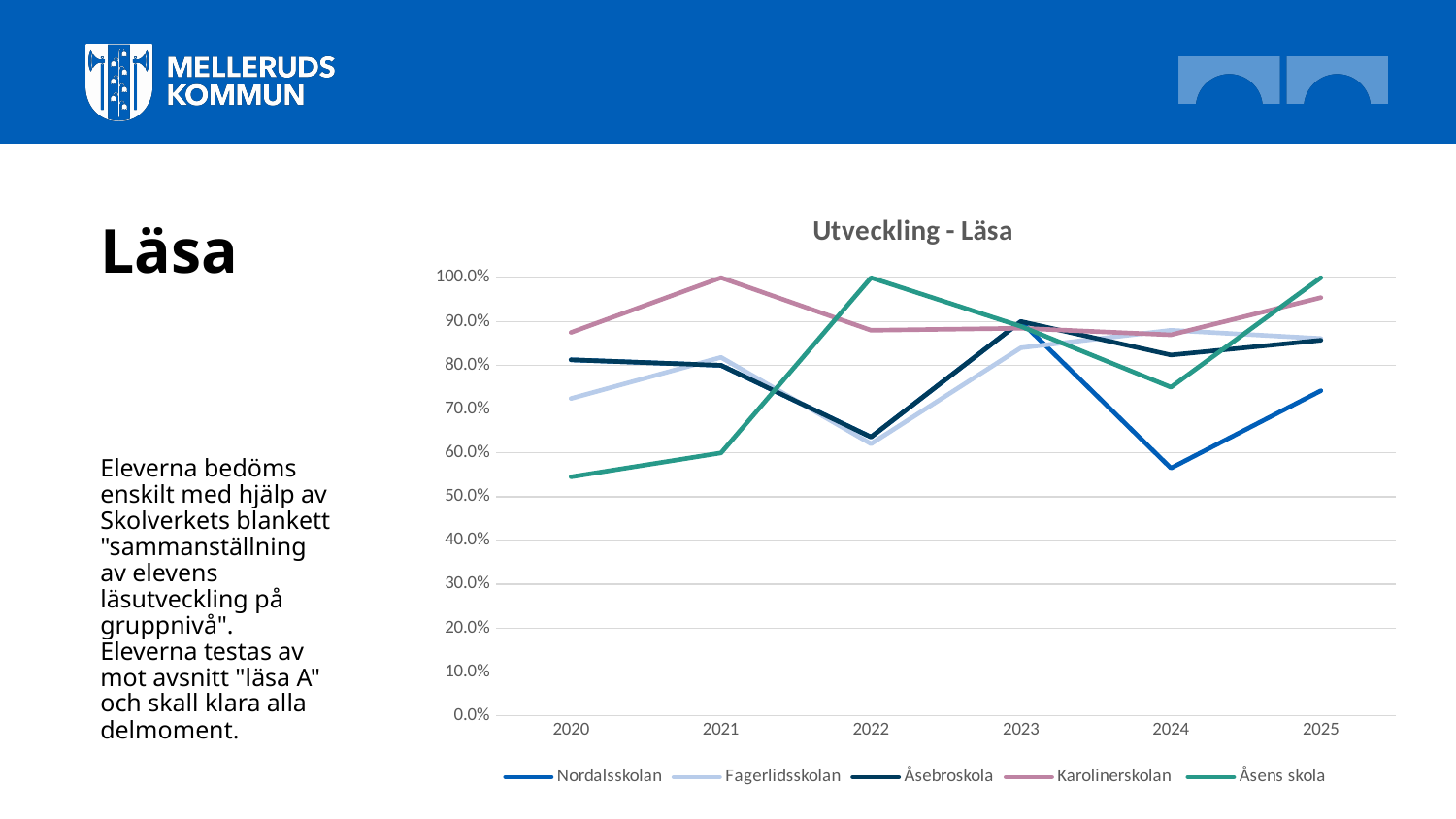
How many series does the legend of the chart list? 5 How many years are shown on the x axis of the chart? 6 Which school has the highest value in 2022? Åsens skola Which school has the lowest value in 2024? Nordalsskolan Is the value for Åsens skola in 2020 greater or less than 50.0%? greater Does the value for Åsens skola rise or fall from 2020 to 2022? rise What kind of chart is shown on the slide? line chart What is the value for Karolinerskolan in 2021? 100.0% What is the value for Åsens skola in 2022? 100.0% Is the value for Åsebroskola in 2022 greater or less than 70.0%? less Is the value for Nordalsskolan in 2024 greater or less than 60.0%? less What is the title of the chart? Utveckling - Läsa